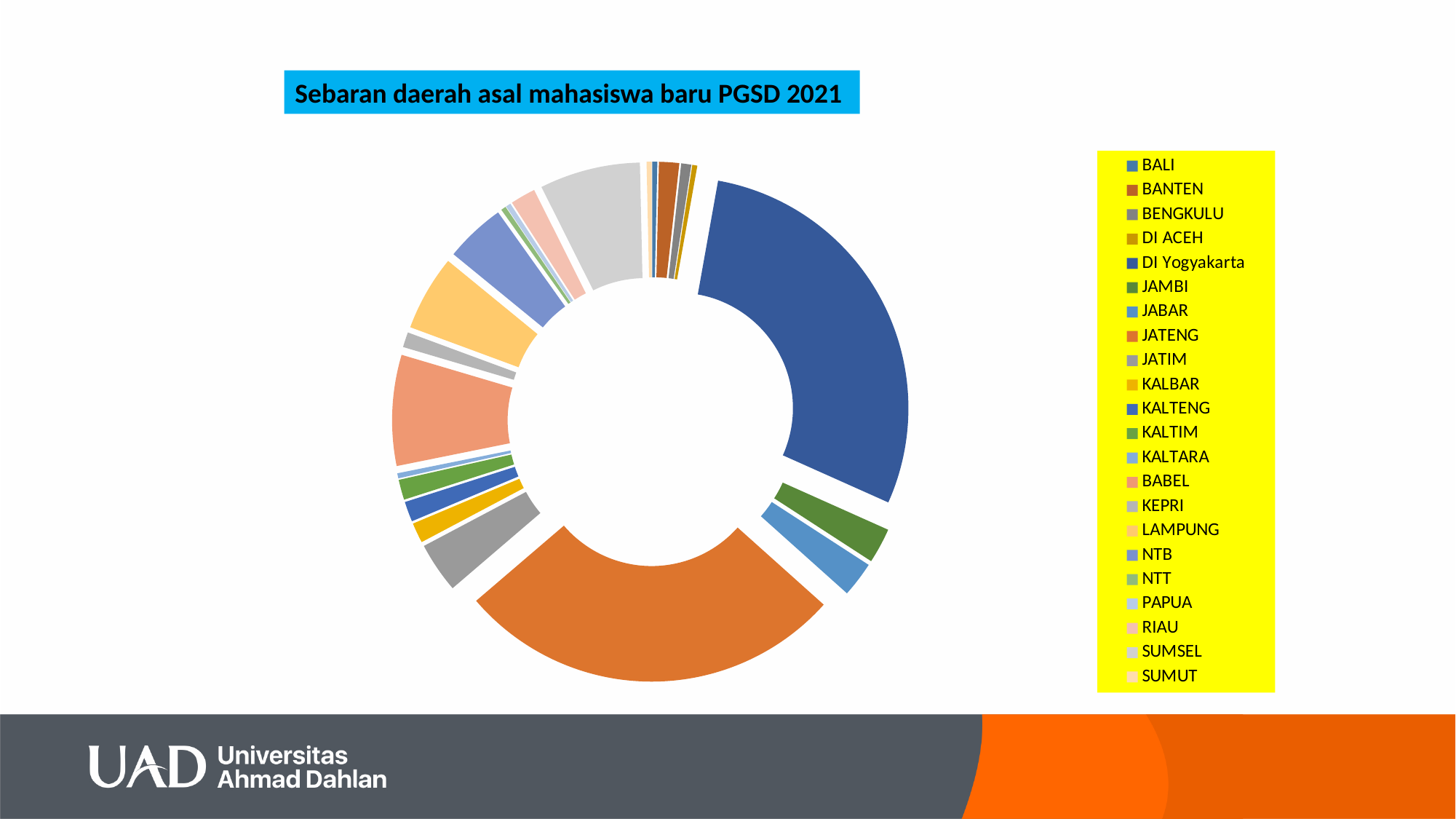
Which slice is larger, BABEL or JAMBI? BABEL Which slice is larger, KALBAR or KALTARA? KALBAR What kind of chart is shown on the slide? doughnut (pie) chart What is the title of the chart? Sebaran daerah asal mahasiswa baru PGSD 2021 How many regions (categories) does the chart's legend list? 22 Which region has the largest slice in the chart? DI Yogyakarta Which slice is larger, DI Yogyakarta or JATENG? DI Yogyakarta What is the first region listed in the legend? BALI